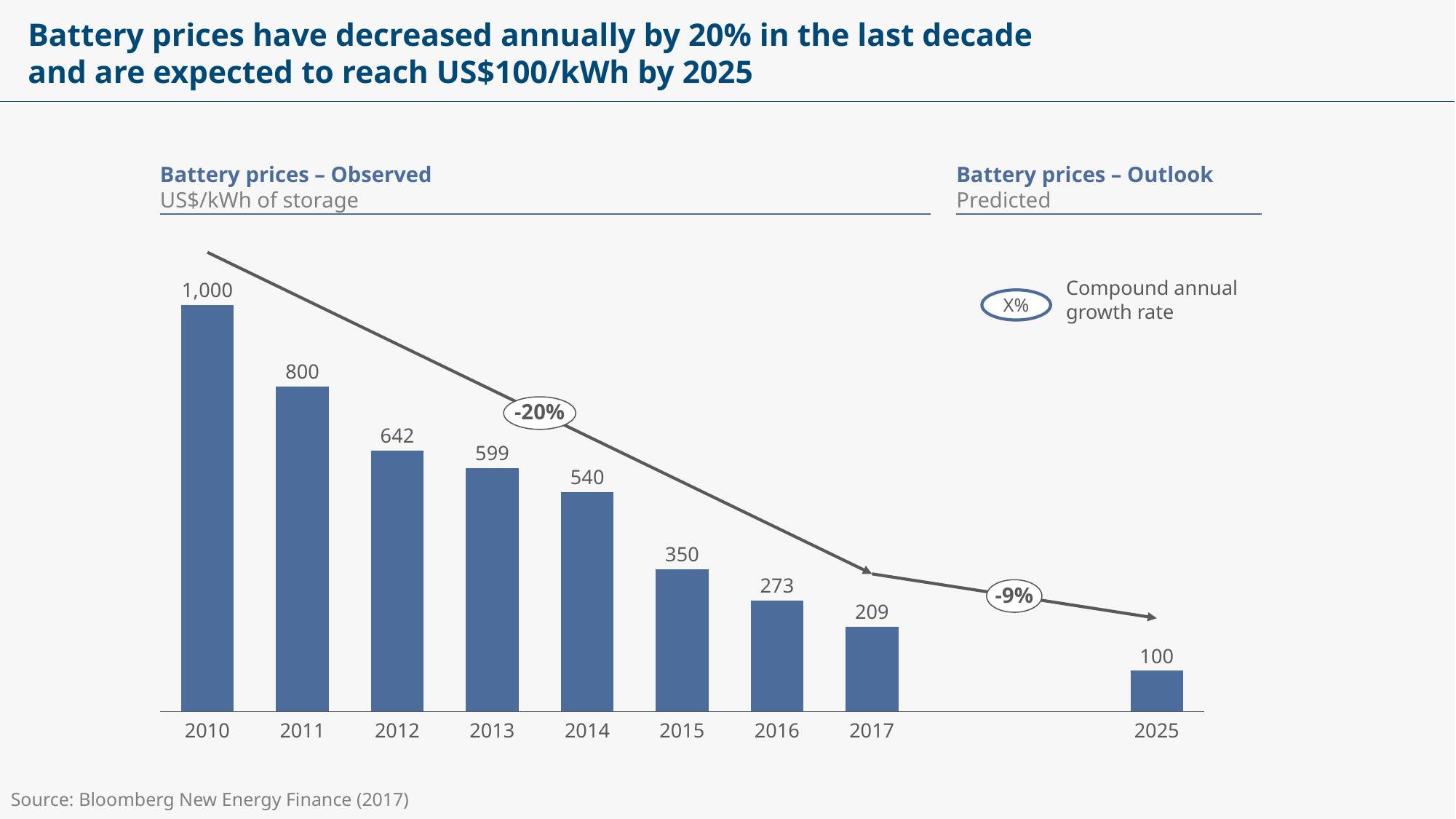
What kind of chart is shown on the slide? Bar chart What is the predicted battery price for 2025? 100 What is the battery price shown for 2010? 1,000 Which year has the lowest battery price on the chart? 2025 What is the difference between the battery price in 2011 and in 2012? 158 Which year has a higher battery price, 2013 or 2016? 2013 What compound annual growth rate is shown for the observed period from 2010 to 2017? -20% How many years are shown as bars on the chart? 9 Which year has the highest battery price on the chart? 2010 What is the battery price shown for 2014? 540 What is the difference between the battery price in 2015 and in 2017? 141 Do battery prices rise or fall from 2010 to 2025 on the chart? Fall